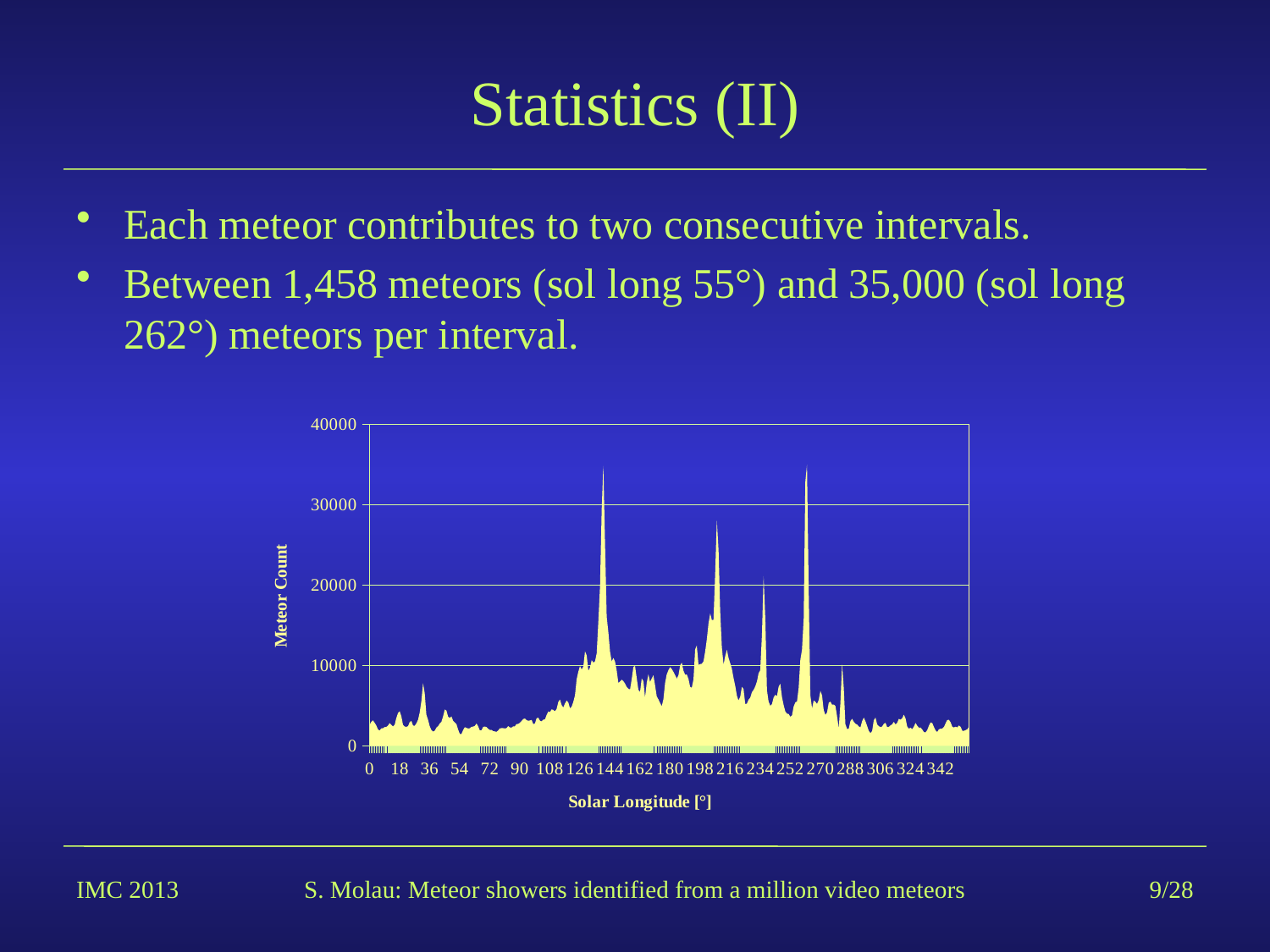
What is the maximum number of meteors per interval? 35,000 At which solar longitude does the meteor count reach its maximum? 262° Is the meteor count at solar longitude 0° greater or less than 10000? less What is the title of the y axis of the chart? Meteor Count Is the highest peak of the chart greater or less than 30000? greater What is the minimum number of meteors per interval? 1,458 Which is larger, the meteor count at solar longitude 36° or the peak near solar longitude 262°? the peak near 262° What kind of chart is shown on the slide? area chart At which solar longitude does the meteor count reach its minimum? 55° Is the meteor count at solar longitude 36° greater or less than 10000? less What is the title of the x axis of the chart? Solar Longitude [°]